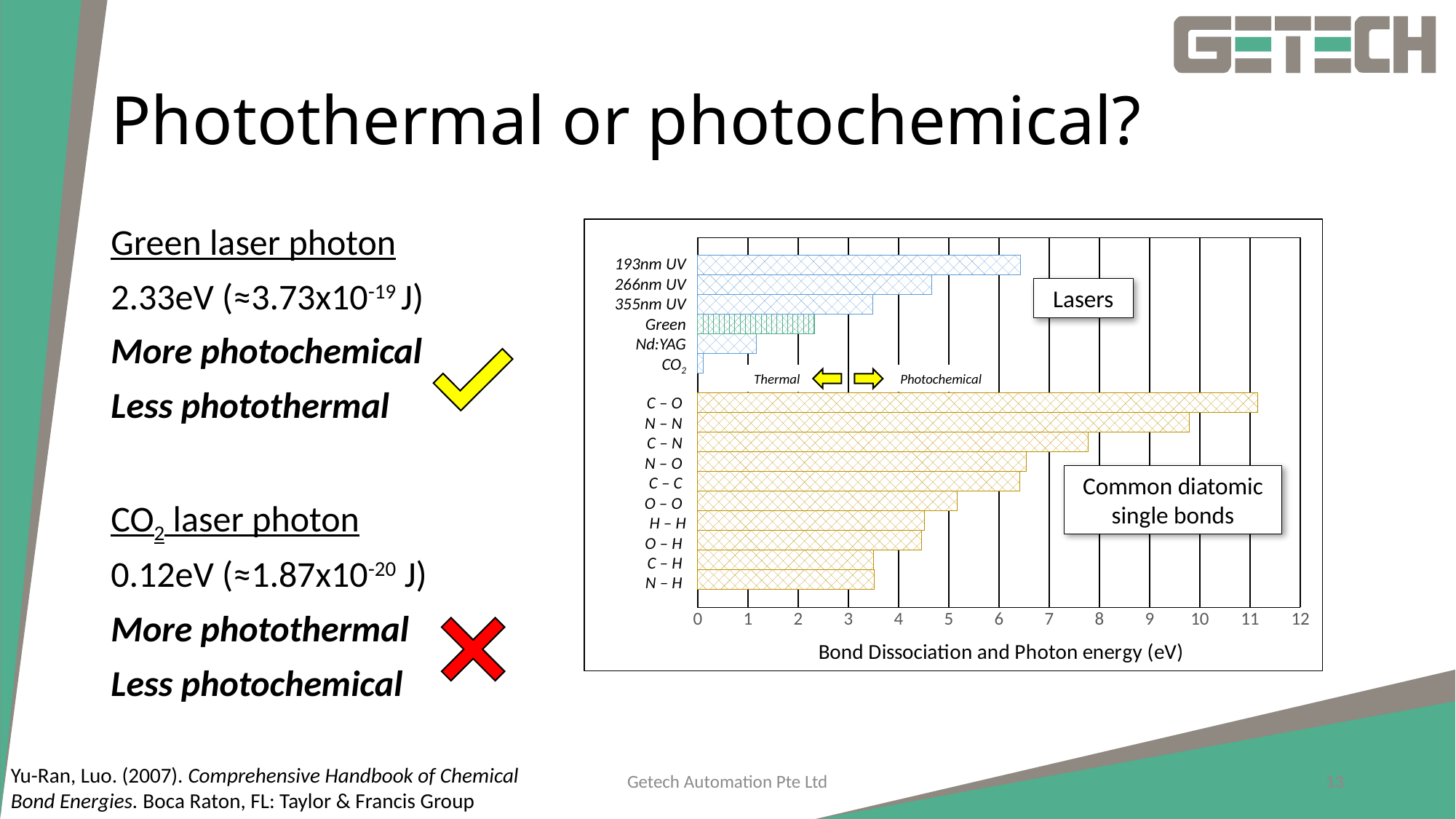
Among the laser bars, which laser has the highest photon energy? 193nm UV What kind of chart is shown on the slide? Bar chart Which category has the lowest value in the chart? CO2 Is the value for 193nm UV greater or less than 5? greater Is the value for Green greater or less than 3? less Which is larger, the value for 193nm UV or the value for 266nm UV? 193nm UV What is the x-axis title of the chart? Bond Dissociation and Photon energy (eV) How many categories (bars) are plotted in the chart? 16 Which category has the highest value in the chart? C – O Is the value for C – O greater or less than 10? greater Which is larger, the value for N – N or the value for C – N? N – N